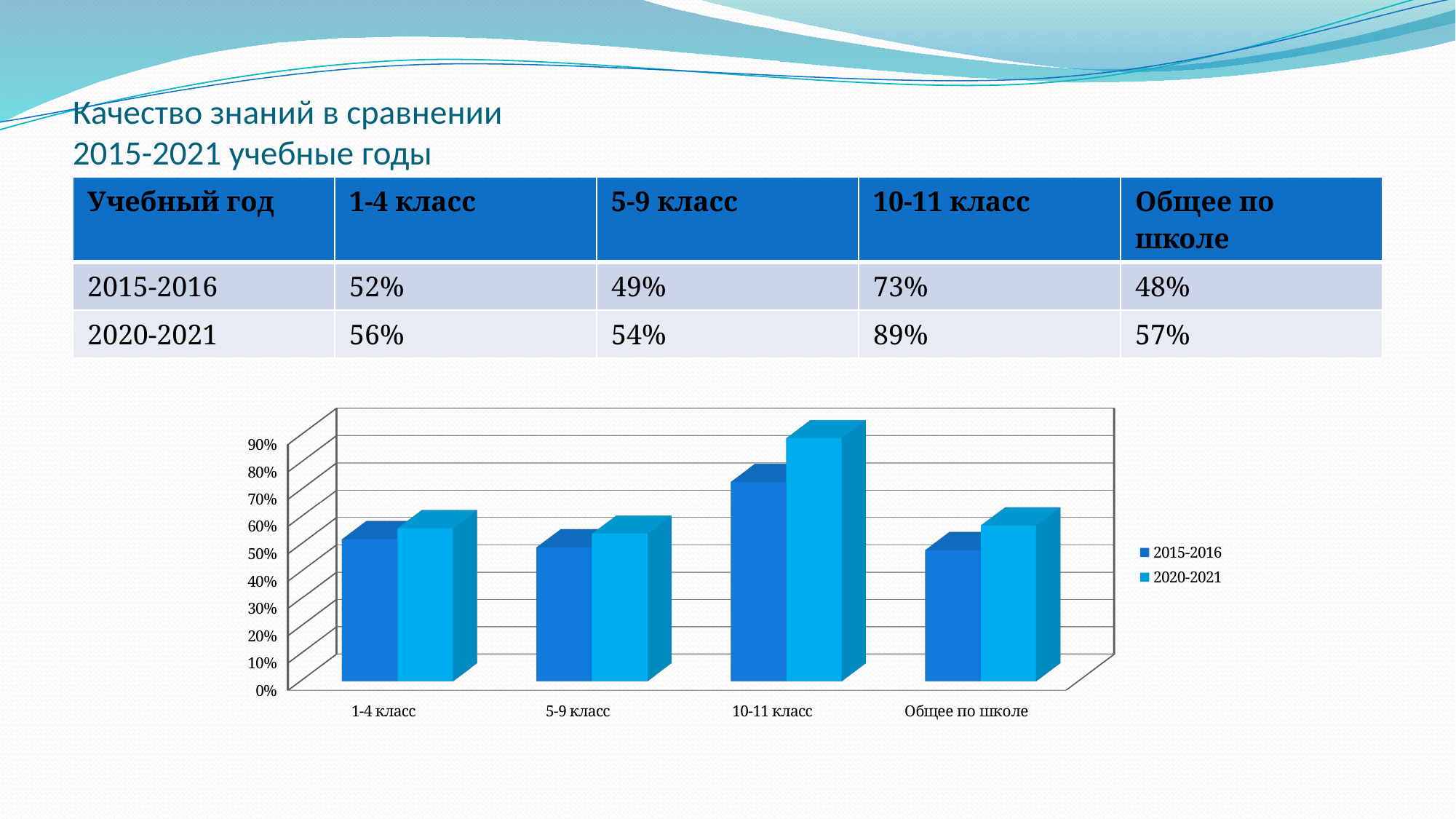
Is the value for 10-11 класс in the 2015-2016 series greater or less than 60%? greater What is the value for Общее по школе in the 2020-2021 series? 57% Which category has the highest value in the 2020-2021 series? 10-11 класс How many series does the chart legend list? 2 Which series is shown in the lighter blue colour in the chart? 2020-2021 Which category has the lowest value in the 2015-2016 series? Общее по школе What is the value for 10-11 класс in the 2020-2021 series? 89% Which is larger for 1-4 класс: the 2015-2016 value or the 2020-2021 value? 2020-2021 How many categories are shown on the x axis of the chart? 4 What is the value for 5-9 класс in the 2015-2016 series? 49% What is the difference between the 2020-2021 and 2015-2016 values for 10-11 класс? 16% What kind of chart is shown on the slide? bar chart